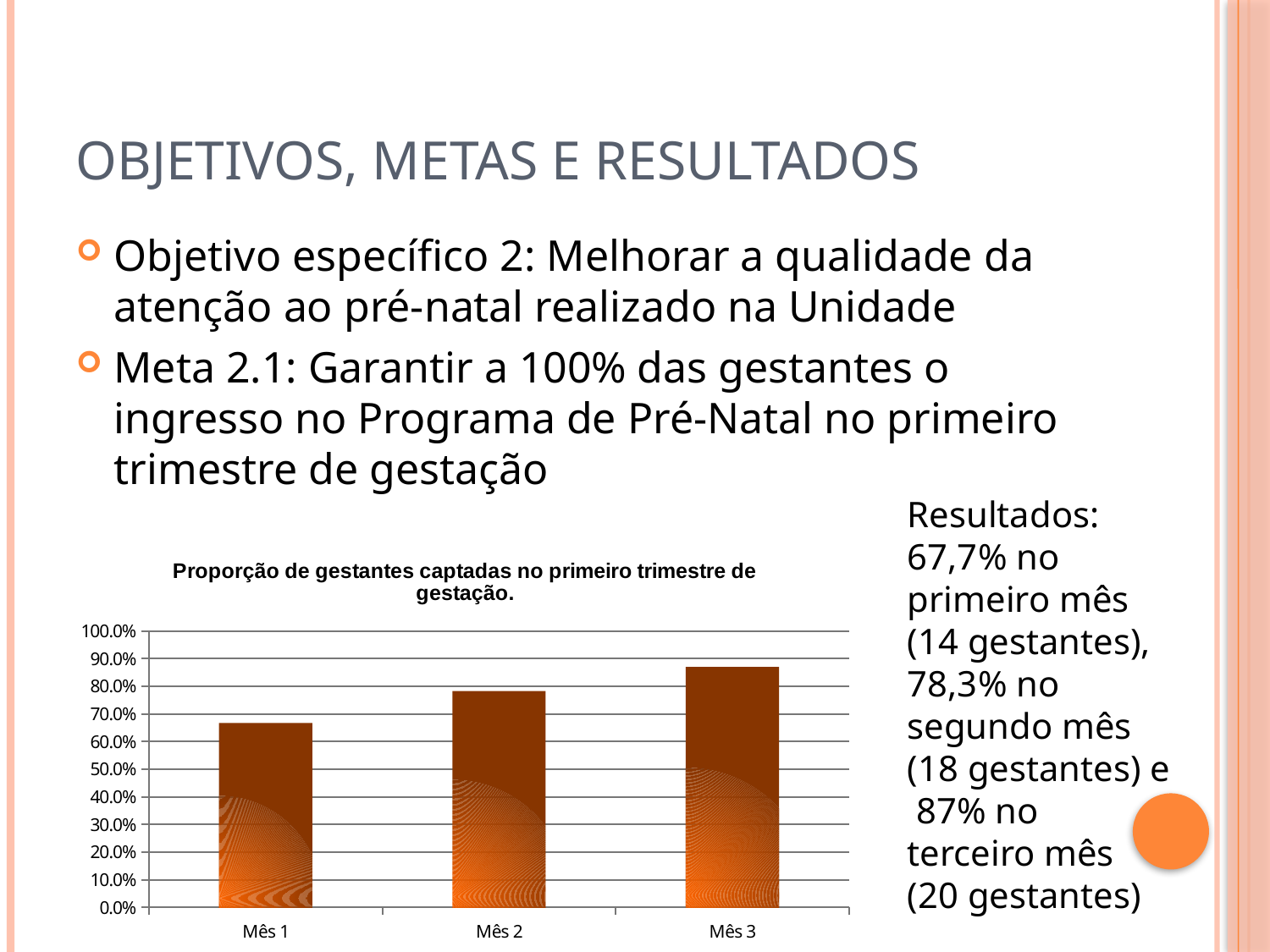
Is the value for Mês 3 greater or less than 90.0%? less Which is larger, the value for Mês 2 or the value for Mês 3? Mês 3 Which month has the highest bar in the chart? Mês 3 What is the title of the chart? Proporção de gestantes captadas no primeiro trimestre de gestação. What type of chart is shown on the slide? bar chart Is the value for Mês 2 greater or less than 70.0%? greater According to the slide, what proportion of pregnant women was captured in the first month (Mês 1)? 67,7% Which month has the lowest bar in the chart? Mês 1 Is the value for Mês 1 greater or less than 70.0%? less According to the slide, what proportion of pregnant women was captured in the third month (Mês 3)? 87% How many categories (months) are plotted on the chart? 3 Do the values rise or fall from Mês 1 to Mês 3? rise